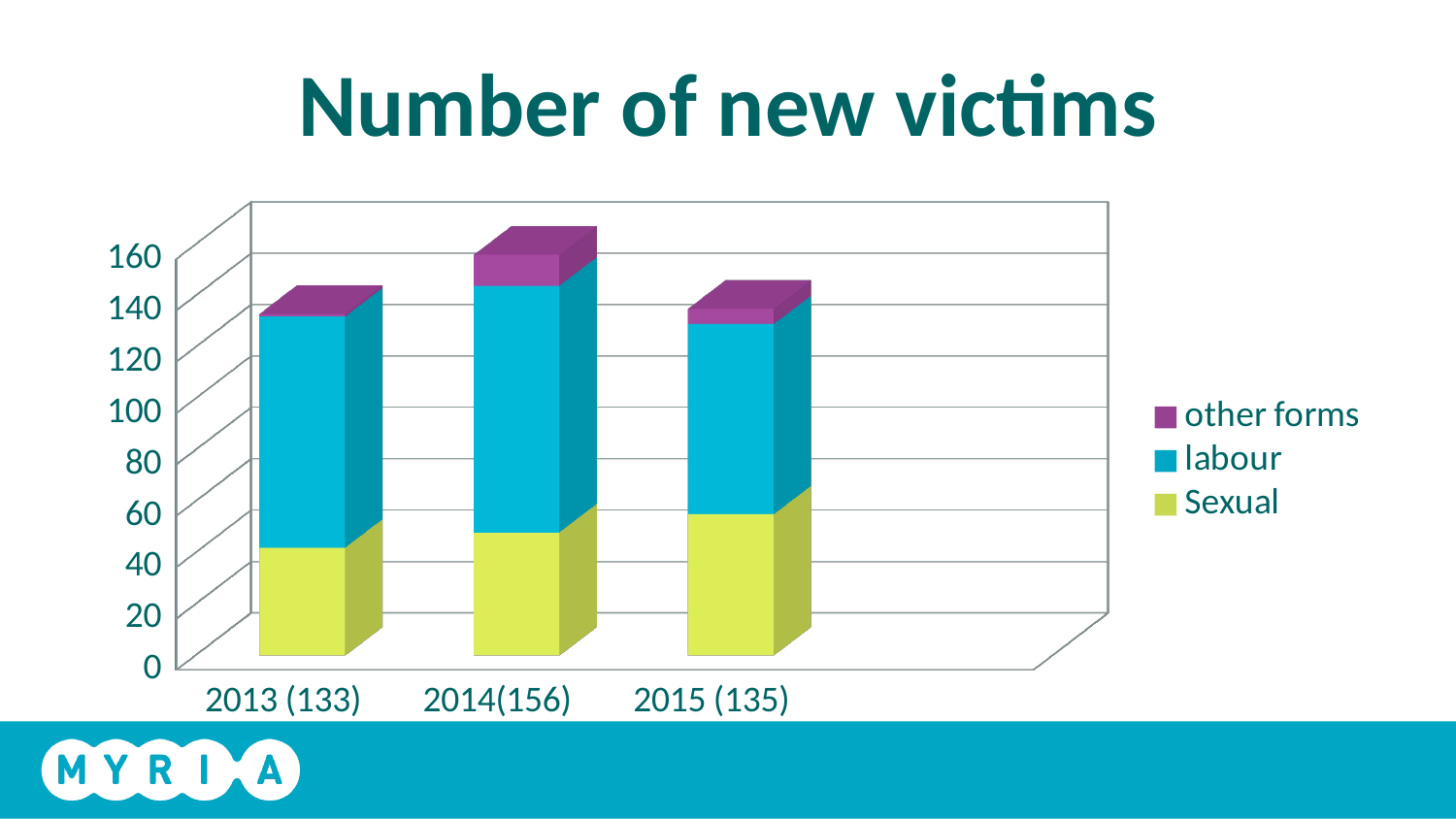
Is the Sexual value for 2013 greater or less than 60? less What kind of chart is shown on the slide? Stacked bar chart Which series is shown in purple in the legend? other forms How many year categories are shown on the x axis? 3 What is the difference between the total for 2014 and the total for 2013? 23 What is the title of the chart? Number of new victims Which year has the highest total number of new victims? 2014 What is the total number of new victims for 2014? 156 Which year has the lowest total number of new victims? 2013 Which year has a larger total, 2015 or 2013? 2015 What is the total number of new victims for 2013? 133 How many series does the legend list? 3